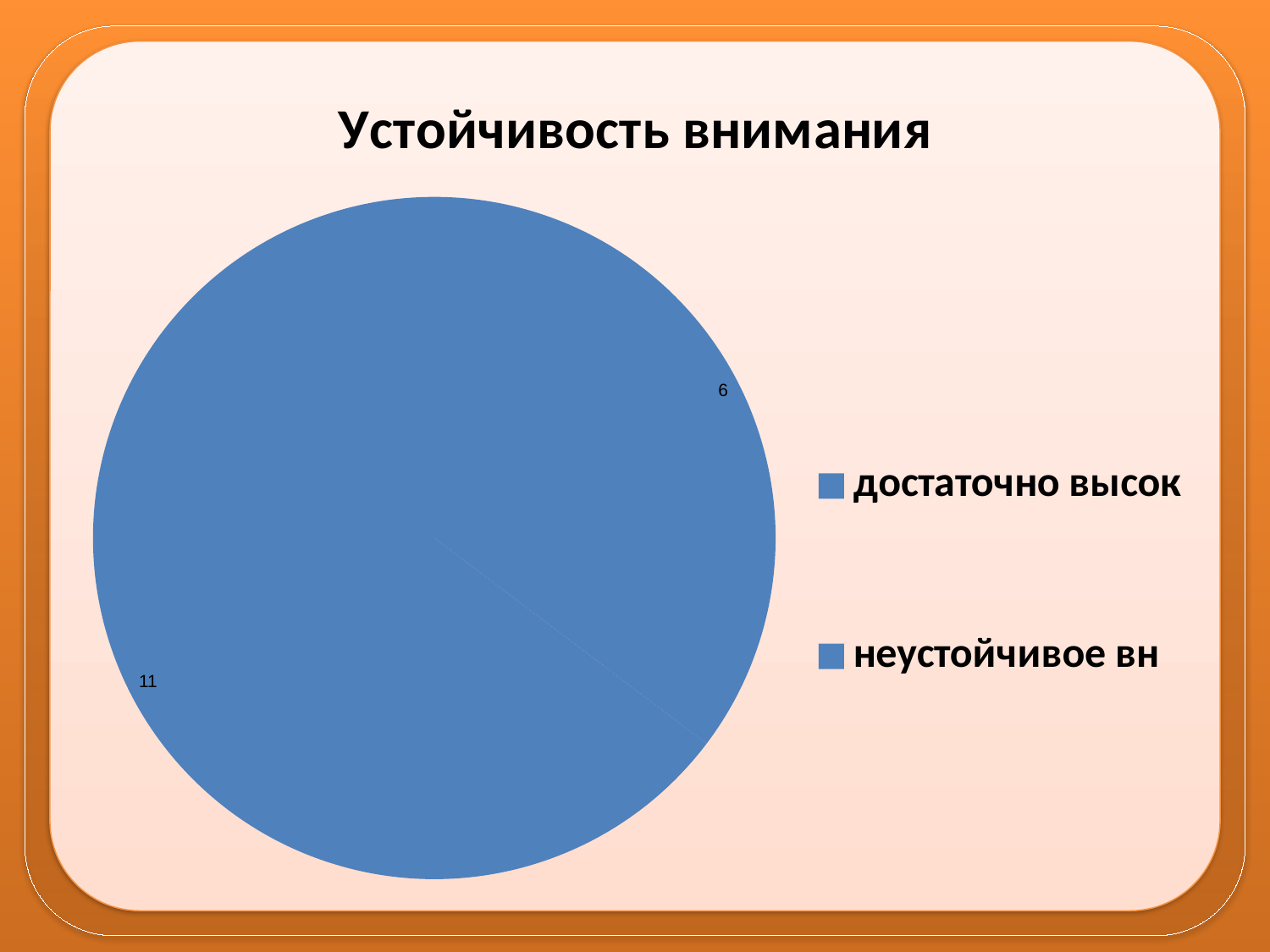
How many categories does the legend list? 2 What kind of chart is shown on the slide? pie chart What is the value of the smaller slice of the pie? 6 What is the difference between the two slice values, 11 and 6? 5 What is the title of the chart? Устойчивость внимания What is the total of the two slice values shown on the pie? 17 What are the two legend entries of the chart? достаточно высок, неустойчивое вн Which is larger, the slice labelled 11 or the slice labelled 6? the slice labelled 11 What is the value of the larger slice of the pie? 11